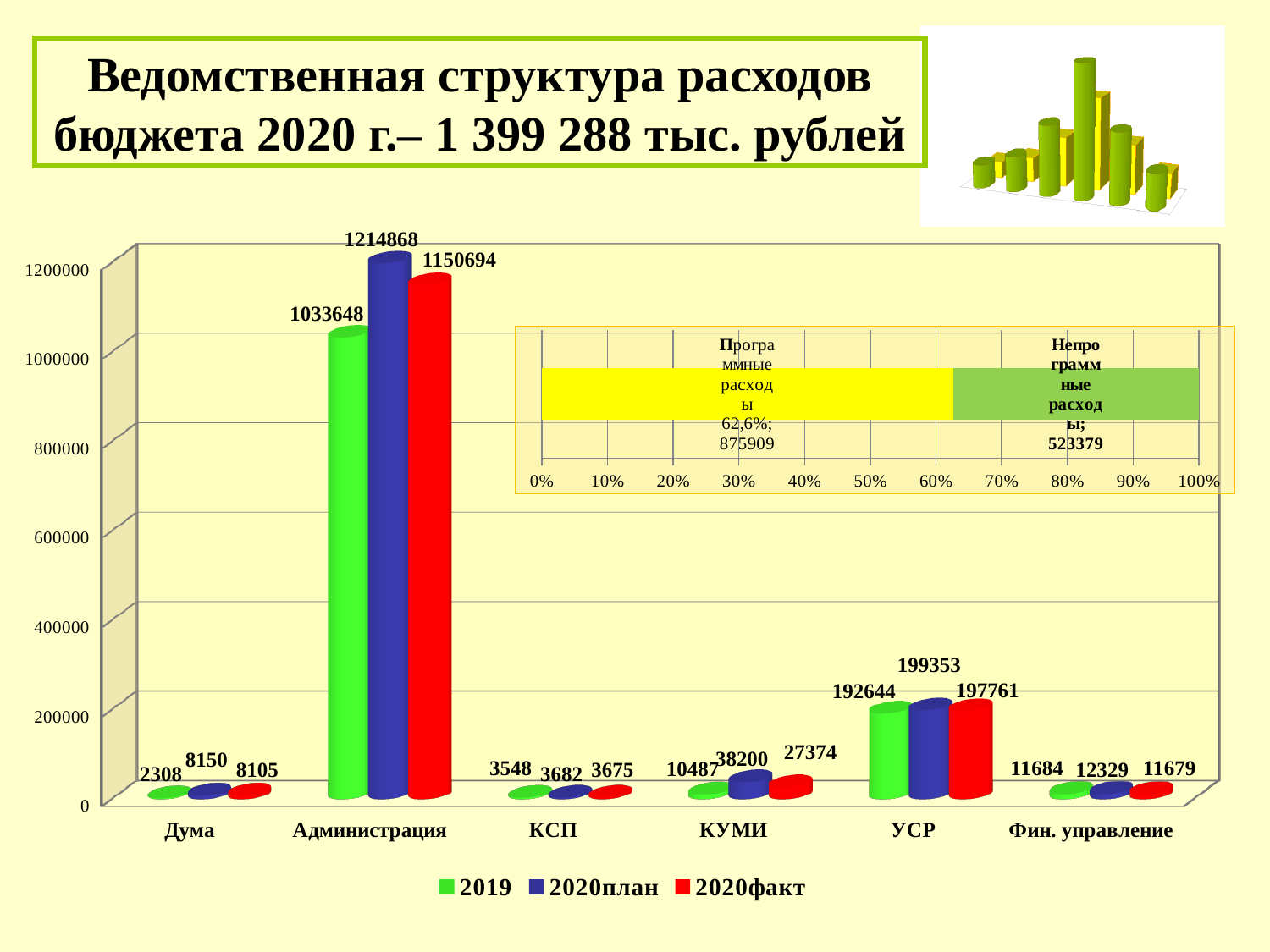
In the large bar chart, what is the 2019 value for УСР? 192644 In the large bar chart, which category has the lowest 2019 value? Дума How many categories are shown on the x axis of the large bar chart? 6 What type of chart is the large chart on the slide? bar chart How many series does the legend of the large bar chart list? 3 In the large bar chart, which category has the highest 2020факт value? Администрация In the large bar chart, what is the difference between the 2020план and 2019 values for КУМИ? 27713 In the large bar chart, what is the 2020план value for Администрация? 1214868 In the large bar chart, which is larger for Фин. управление: the 2019 value or the 2020план value? 2020план In the large bar chart, what is the difference between the 2020план and 2020факт values for Администрация? 64174 In the large bar chart, what is the 2020факт value for КУМИ? 27374 In the small inset chart, what share of expenses is Программные расходы? 62,6%